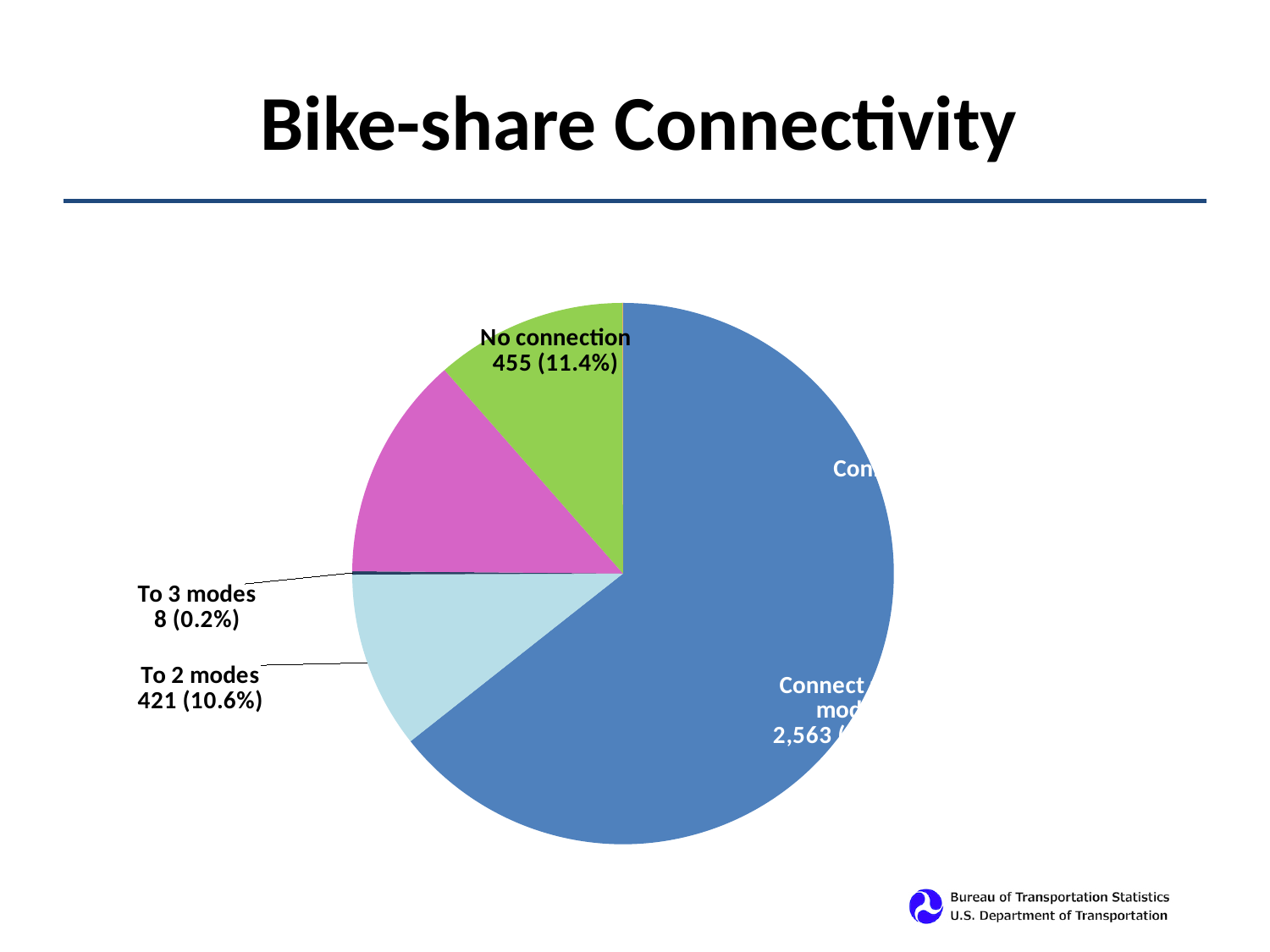
Which category has the smallest share of the pie? To 3 modes What is the title of the chart? Bike-share Connectivity What is the value shown for the 'To 2 modes' slice? 421 What is the value shown for the 'No connection' slice? 455 What is the value shown for the 'To 3 modes' slice? 8 Which is larger, 'No connection' or 'To 2 modes'? No connection What kind of chart is shown on the slide? pie chart What share of the pie does 'To 3 modes' represent? 0.2% What share of the pie does 'No connection' represent? 11.4% What share of the pie does 'To 2 modes' represent? 10.6% What is the difference between the 'No connection' value and the 'To 2 modes' value? 34 How many slices does the pie chart have? 5